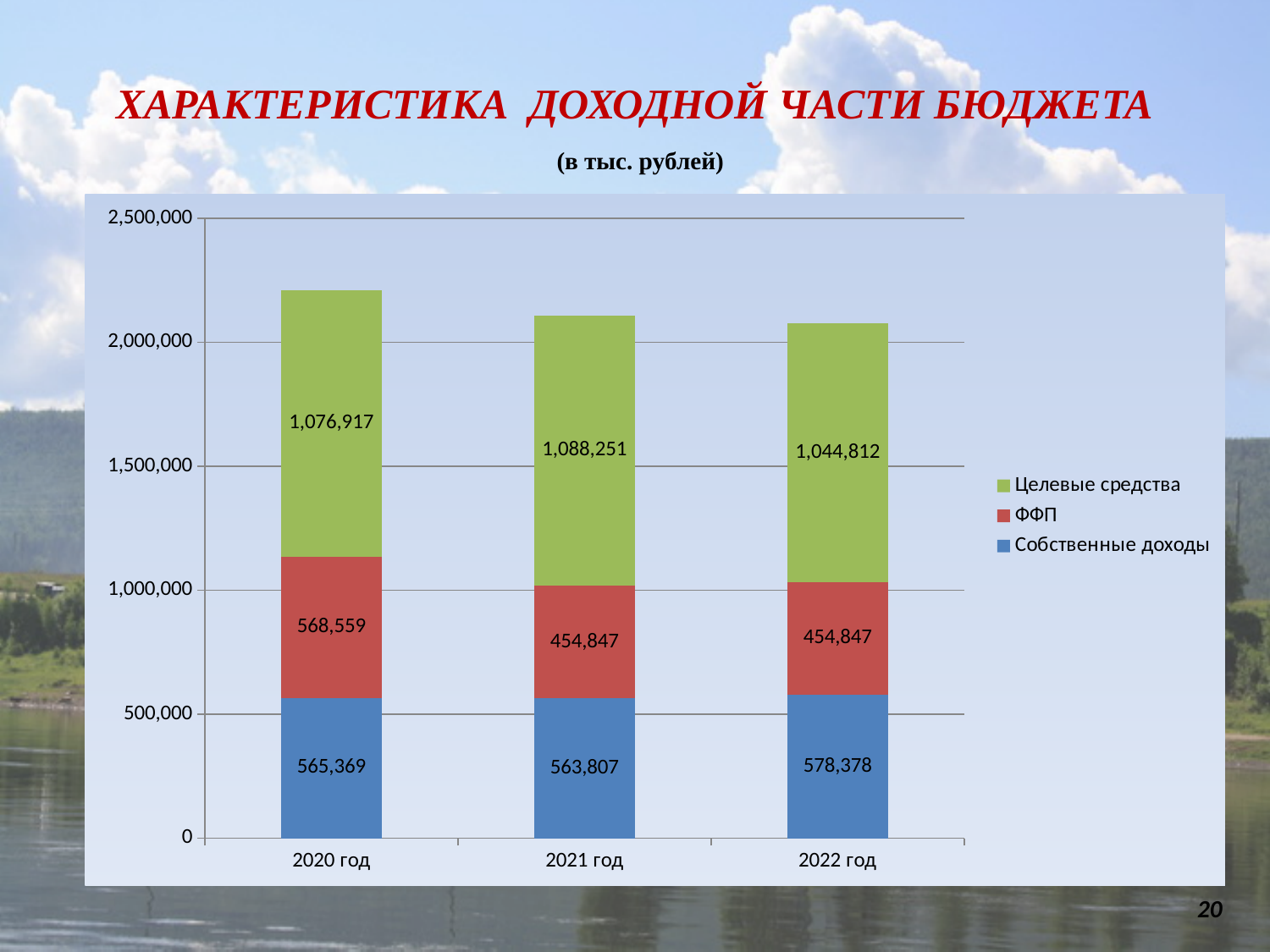
How many years (categories) are shown on the x axis? 3 What is the value of Целевые средства for 2021 год? 1,088,251 In which year is Целевые средства the lowest? 2022 год What type of chart is shown on the slide? Stacked bar chart What is the difference between ФФП in 2020 год and in 2021 год? 113,712 What is the total of the stacked bar for 2020 год? 2,210,845 How many series does the legend list? 3 Which series is shown in green in the legend? Целевые средства In which year is Собственные доходы the highest? 2022 год Which is larger: Целевые средства in 2020 год or in 2021 год? 2021 год What is the value of Собственные доходы for 2022 год? 578,378 What is the value of ФФП for 2020 год? 568,559